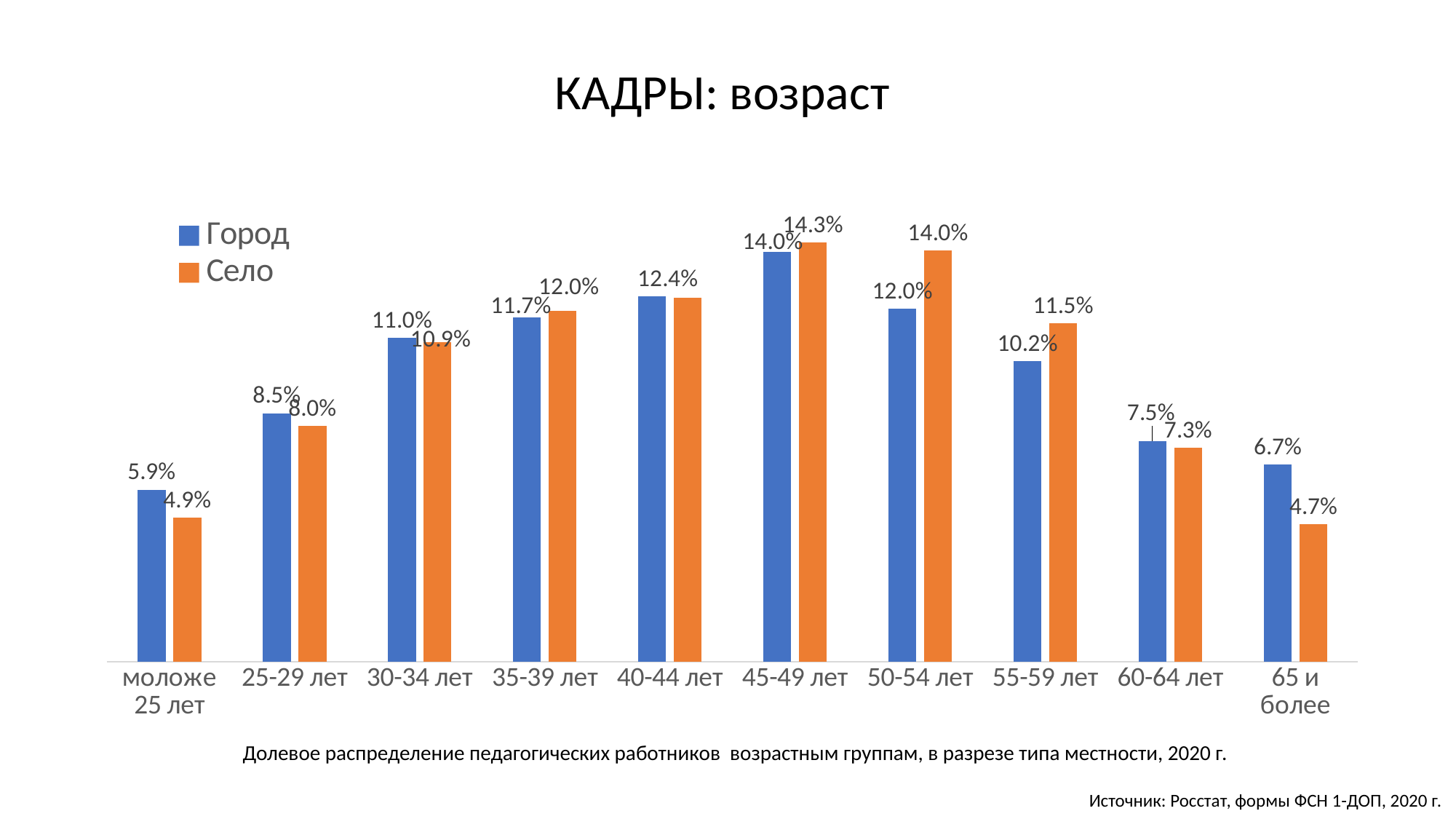
Which age category has the lowest value for Город? моложе 25 лет In the 65 и более category, which is larger: Город or Село? Город What is the value for Село in the 55-59 лет category? 11.5% Which age category has the highest value for Село? 45-49 лет What is the value for Село in the 65 и более category? 4.7% Which age category has the lowest value for Село? 65 и более What is the value for Город in the 50-54 лет category? 12.0% In the 55-59 лет category, which is larger: Город or Село? Село How many series does the legend list? 2 How many age categories are shown on the x axis? 10 What type of chart is shown on the slide? Bar chart What is the difference between Село and Город in the 50-54 лет category? 2.0%